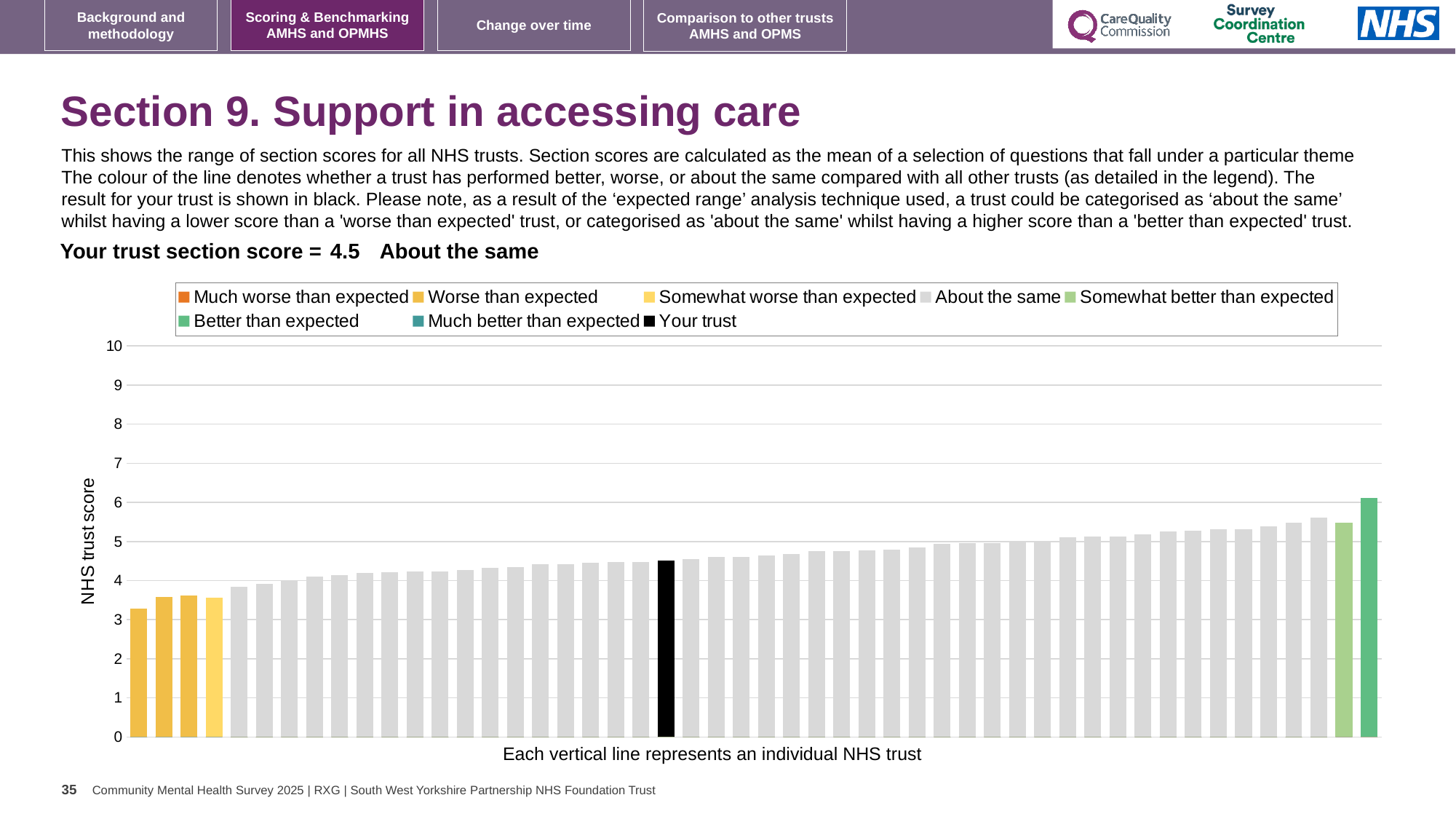
Is the value of the black 'Your trust' bar greater or less than 4? greater Is the value of the black 'Your trust' bar greater or less than 5? less What is the label on the vertical axis of the chart? NHS trust score What is the section score for your trust shown on the slide? 4.5 What kind of chart is shown on the slide? Bar chart Is the value of the leftmost (lowest) bar greater or less than 4? less Do the bar values rise or fall from left to right across the chart? Rise Which legend category does the tallest bar on the chart belong to? Better than expected How many entries does the chart legend list? 8 How many bars are coloured yellow (Worse than expected) in the chart? 3 What colour is used for the 'Your trust' bar in the chart? Black Which performance category is your trust placed in for this section? About the same